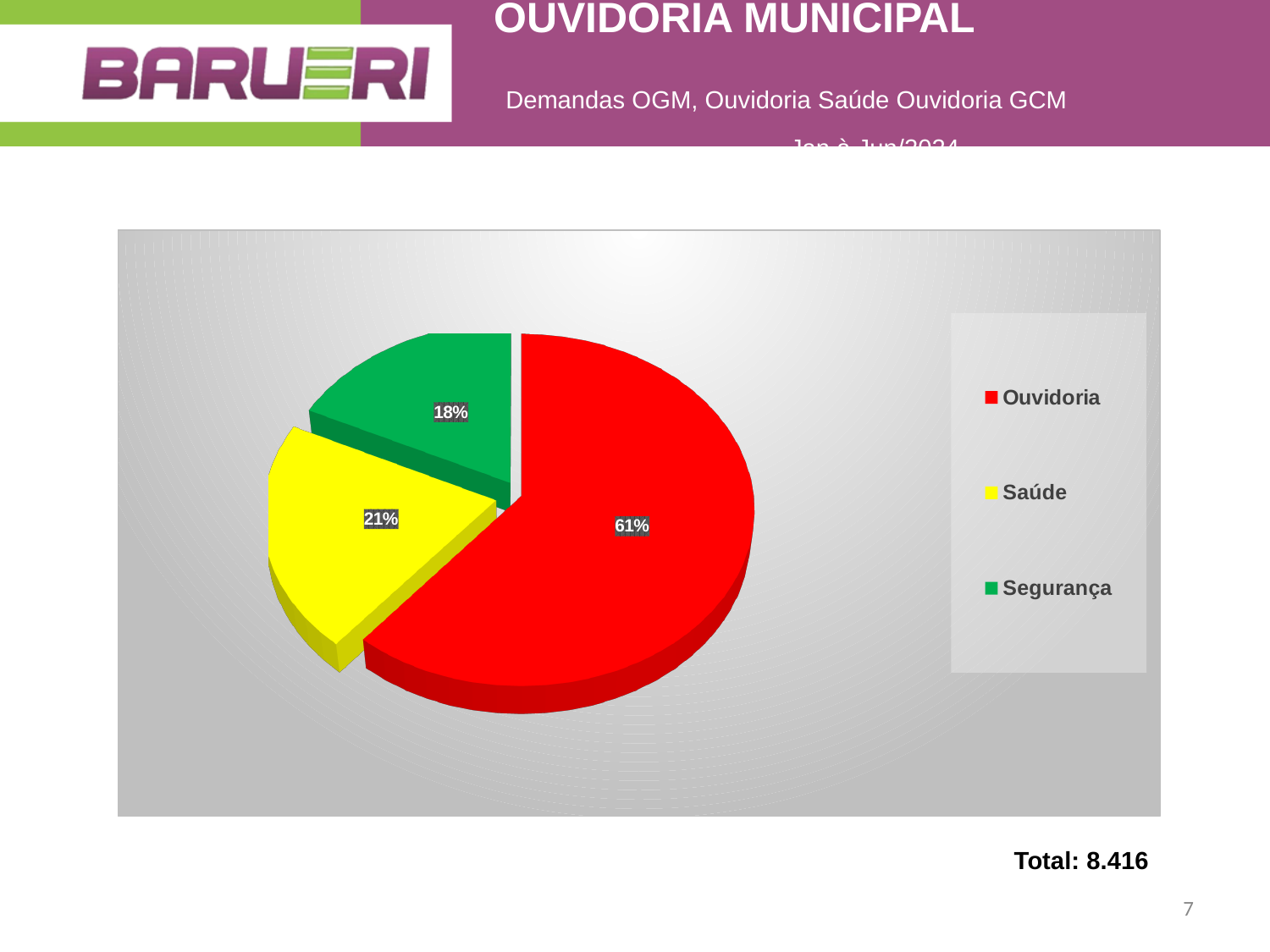
What colour is the Saúde slice in the pie chart? yellow What total is printed below the chart? 8.416 What share of the pie does Saúde represent? 21% What share of the pie does Segurança represent? 18% How many entries does the legend list? 3 What kind of chart is shown on the slide? pie chart How many slices does the pie chart have? 3 Which category has the smallest slice of the pie? Segurança Which slice is larger, Saúde or Segurança? Saúde What is the difference in percentage points between the Ouvidoria slice and the Saúde slice? 40 What share of the pie does Ouvidoria represent? 61% Which category has the largest slice of the pie? Ouvidoria